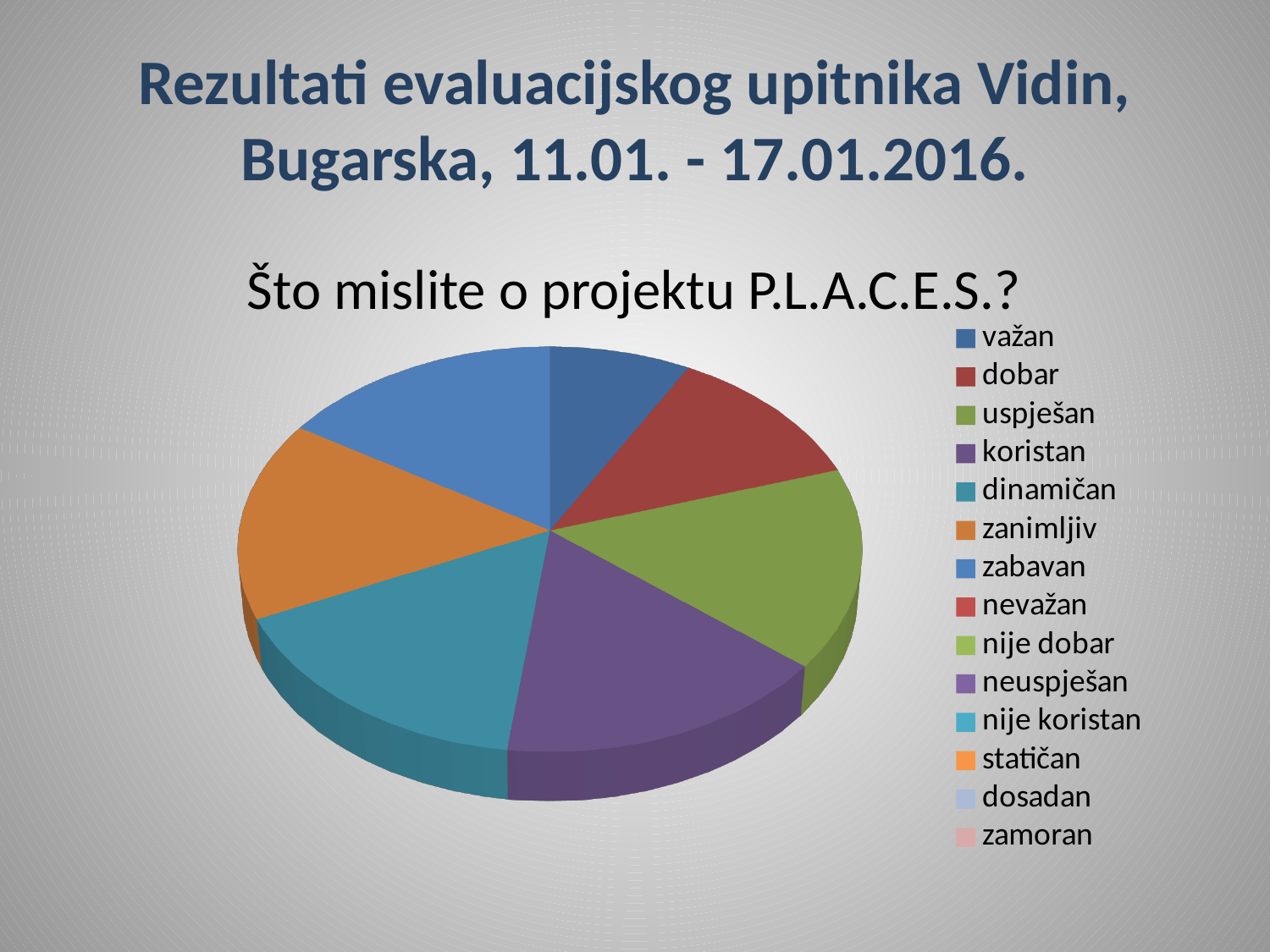
Which slice is larger, važan or zanimljiv? zanimljiv Which category has the smallest visible slice in the pie chart? važan Which slice is larger, dobar or koristan? koristan What is the last entry listed in the legend? zamoran What is the first entry listed in the legend? važan Which slice is larger, važan or koristan? koristan What kind of chart is shown on the slide? pie chart What is the title of the chart? Što mislite o projektu P.L.A.C.E.S.? How many entries does the chart's legend list? 14 How many slices are visible in the pie chart? 7